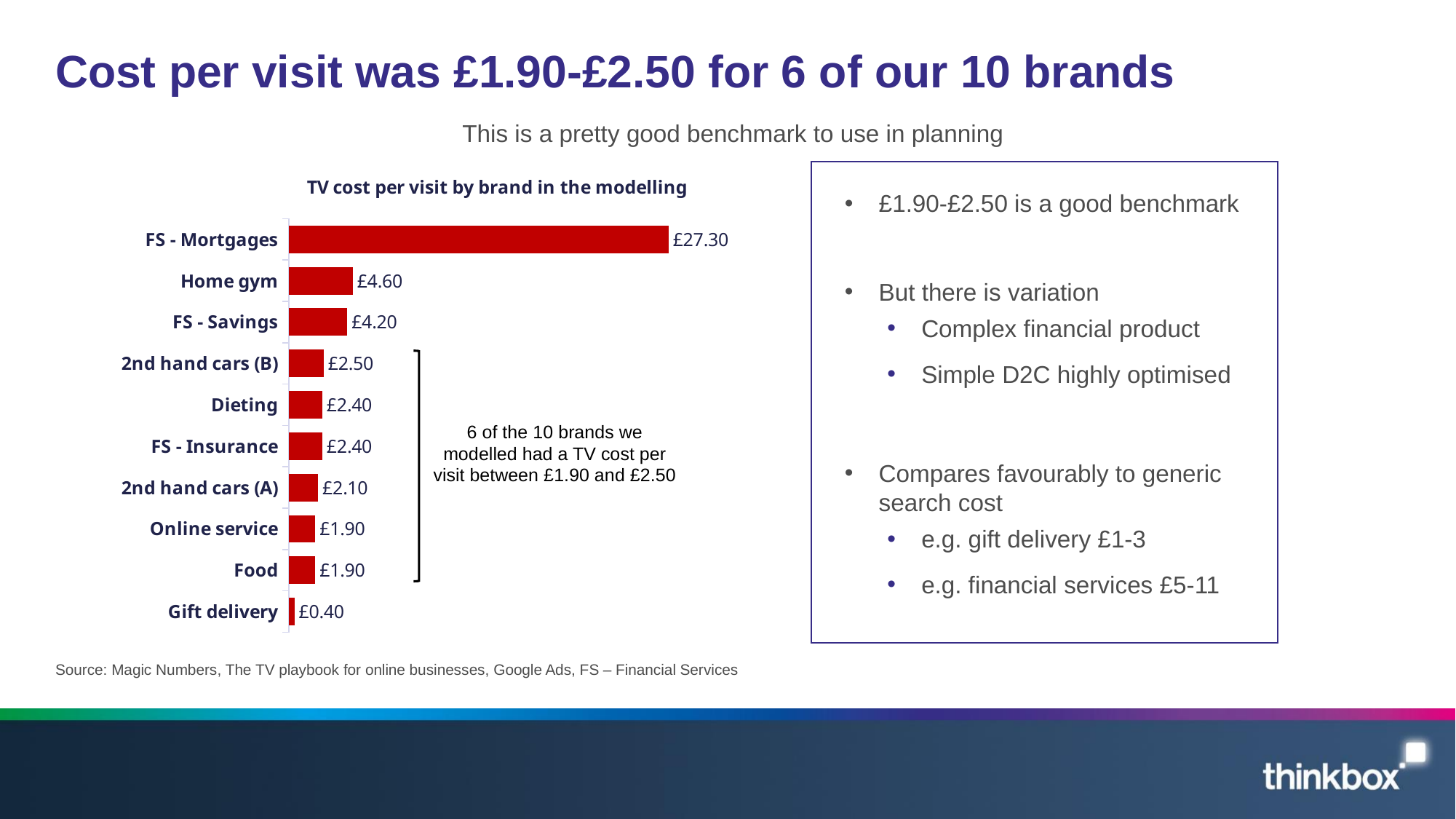
What is the difference in TV cost per visit between FS - Mortgages and Gift delivery? £26.90 What is the TV cost per visit for FS - Mortgages? £27.30 What is the TV cost per visit for 2nd hand cars (A)? £2.10 What is the TV cost per visit for Home gym? £4.60 What type of chart is used to show TV cost per visit by brand? Bar chart Which brand has the highest TV cost per visit? FS - Mortgages Which has a higher TV cost per visit, 2nd hand cars (B) or Online service? 2nd hand cars (B) What is the difference in TV cost per visit between Home gym and FS - Savings? £0.40 What is the title of the chart? TV cost per visit by brand in the modelling Which brand has the lowest TV cost per visit? Gift delivery How many brands are shown in the chart? 10 What is the TV cost per visit for Gift delivery? £0.40